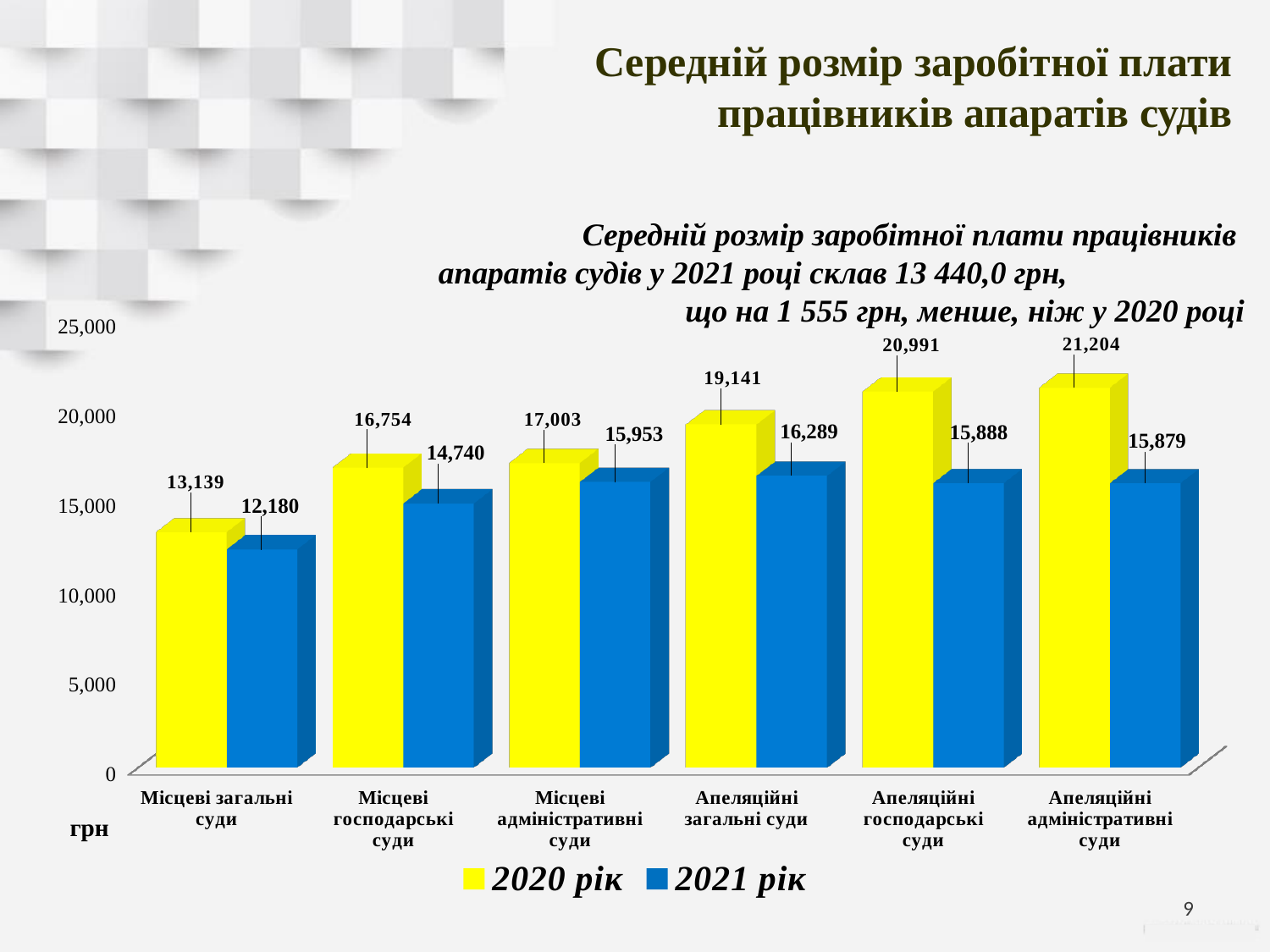
Which colour represents the 2021 рік series? blue How many series does the legend list? 2 Which category has the lowest value in the 2021 рік series? Місцеві загальні суди What is the value for Місцеві загальні суди in the 2020 рік series? 13,139 What is the difference between the 2020 рік and 2021 рік values for Апеляційні загальні суди? 2,852 How many categories are shown on the x axis? 6 What is the value for Апеляційні господарські суди in the 2021 рік series? 15,888 What kind of chart is shown on the slide? bar chart Which is larger for Місцеві господарські суди: the 2020 рік value or the 2021 рік value? 2020 рік What is the value for Місцеві адміністративні суди in the 2020 рік series? 17,003 Is the 2021 рік value for Місцеві загальні суди greater or less than 15,000? less Which category has the highest value in the 2020 рік series? Апеляційні адміністративні суди